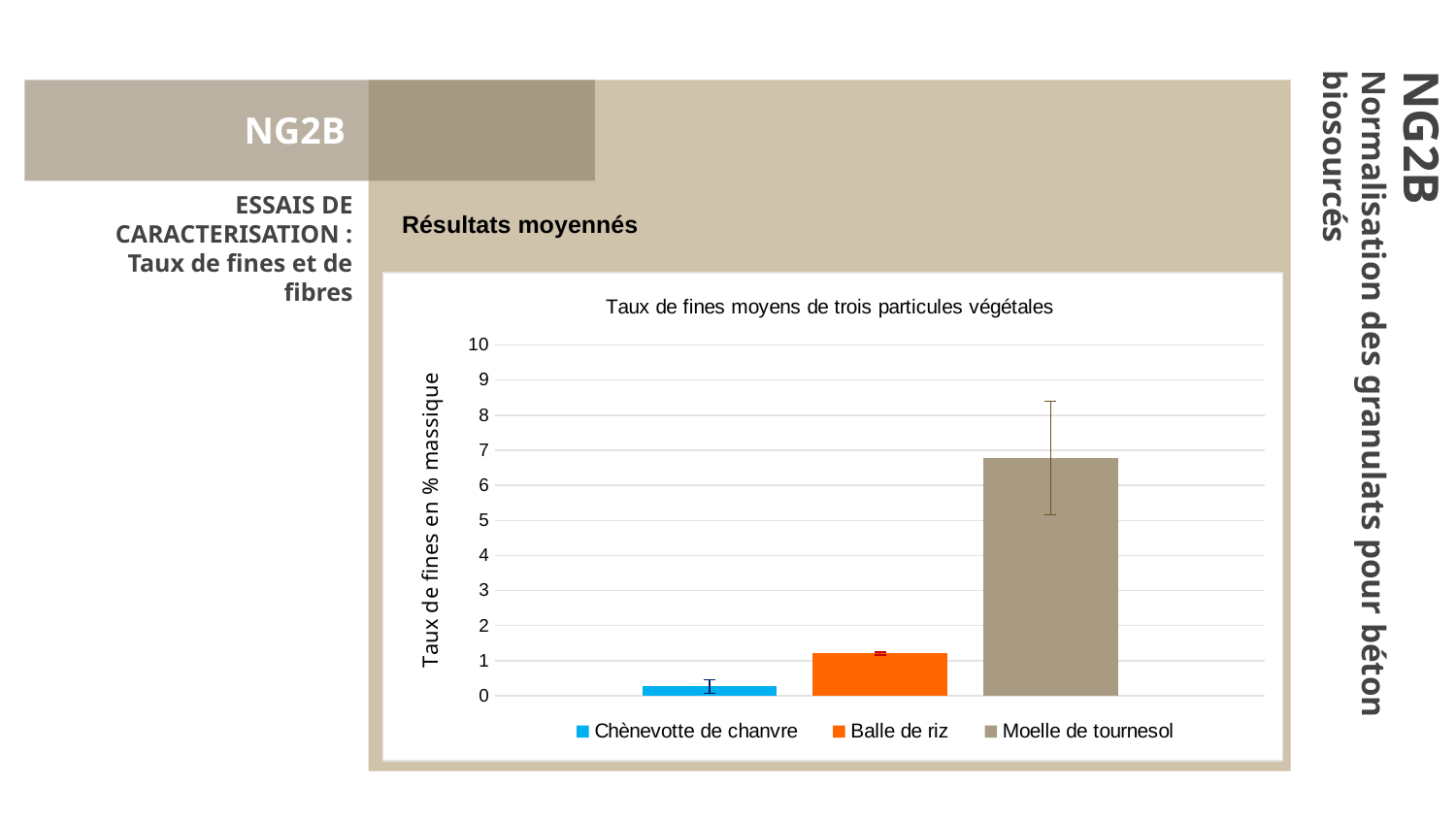
Is the value for Moelle de tournesol greater or less than 5? greater Which material has the lowest taux de fines? Chènevotte de chanvre How many series does the legend list? 3 Do the bar values rise or fall from left to right? rise How many bars are plotted in the chart? 3 What is the label of the vertical axis? Taux de fines en % massique What kind of chart is shown on the slide? bar chart Is the value for Chènevotte de chanvre greater or less than 1? less Is the value for Balle de riz greater or less than 2? less What is the title of the chart? Taux de fines moyens de trois particules végétales Which has a higher taux de fines, Balle de riz or Chènevotte de chanvre? Balle de riz Which material has the highest taux de fines? Moelle de tournesol